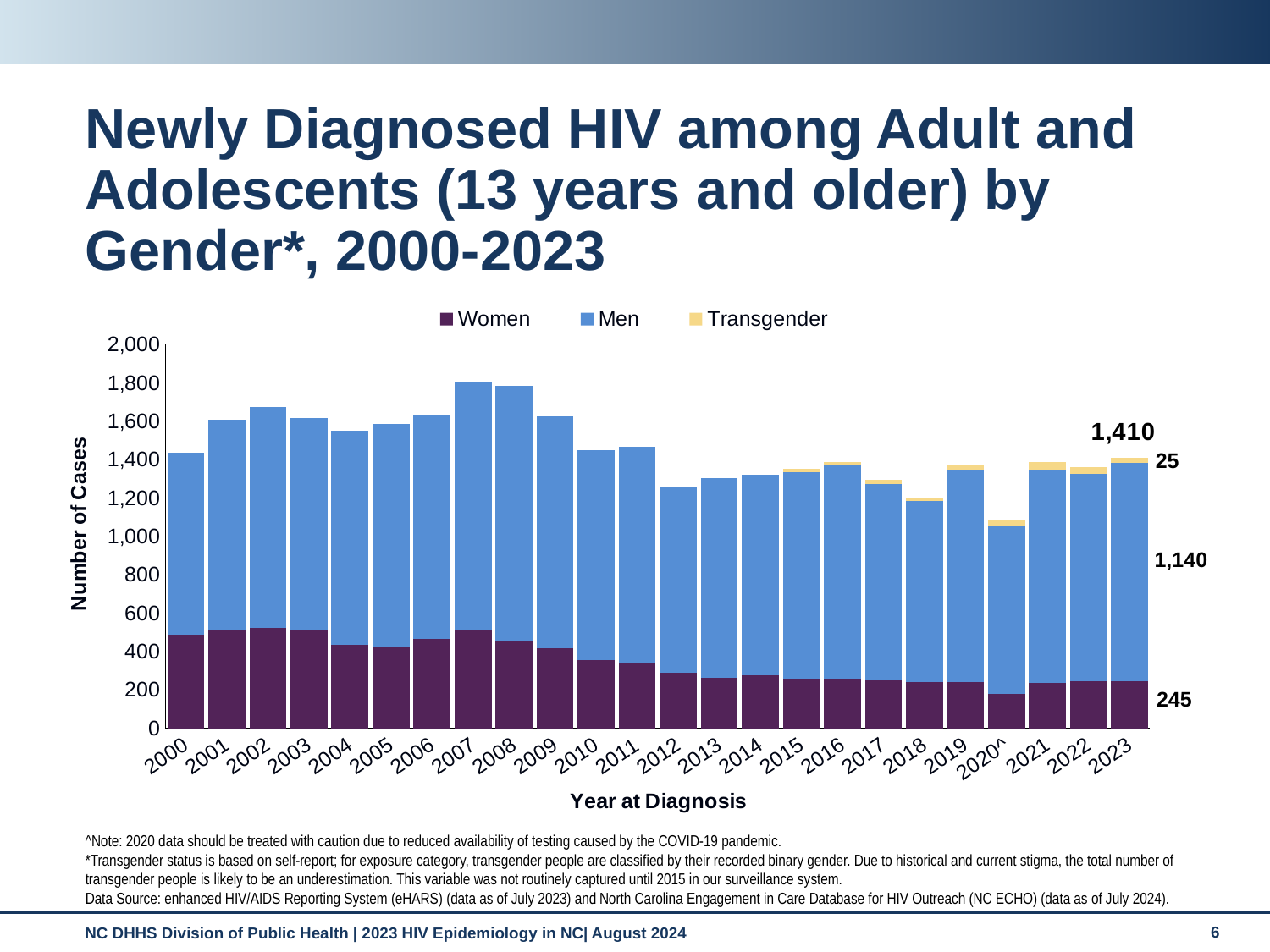
What is the number of cases for Transgender in 2023? 25 What is the difference between the Men and Women values in 2023? 895 What kind of chart is shown on the slide? Bar chart How many years are shown along the x axis? 24 Which is larger, the Women value for 2002 or the Women value for 2023? 2002 Which year has the lowest total number of cases? 2020^ How many series does the legend list? 3 Is the total number of cases for 2007 greater or less than 1,600? greater What is the title of the y axis? Number of Cases What is the total number of cases for 2023? 1,410 What is the number of cases for Men in 2023? 1,140 What is the number of cases for Women in 2023? 245